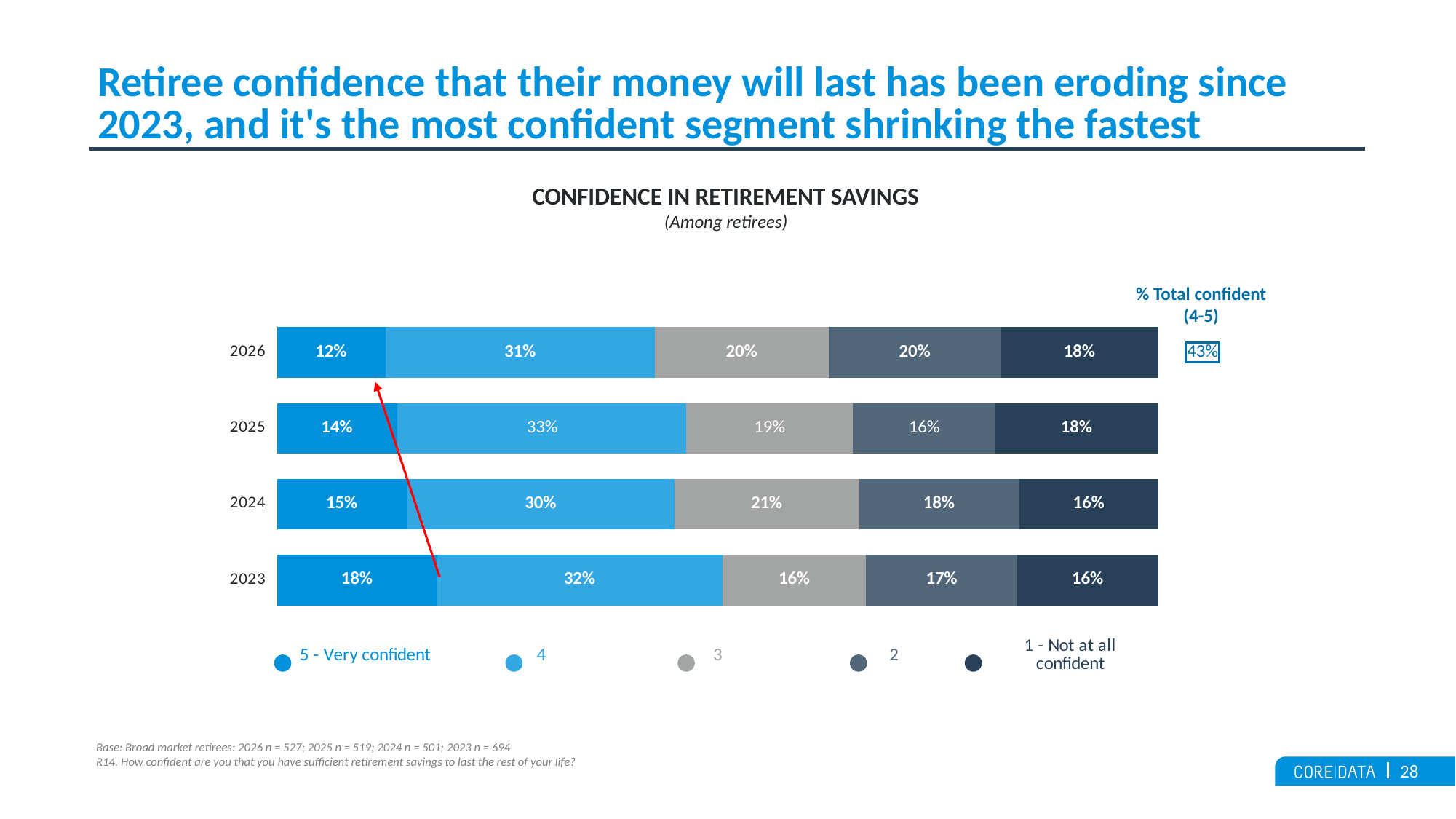
How many series does the legend list? 5 What percentage of retirees were '5 - Very confident' in 2026? 12% Which is larger: the share rating 3 in 2024 or the share rating 3 in 2023? 2024 Which year has the highest share of '5 - Very confident' retirees? 2023 What is the difference in the '5 - Very confident' share between 2023 and 2026? 6 percentage points Which year has the lowest share of '5 - Very confident' retirees? 2026 What percentage of retirees were '1 - Not at all confident' in 2024? 16% What is the combined share of ratings 4 and 5 in 2023? 50% What is the '% Total confident (4-5)' figure shown for 2026? 43% How many years are shown in the chart? 4 What percentage of retirees gave a rating of 4 in 2023? 32% What kind of chart is shown on the slide? Stacked bar chart